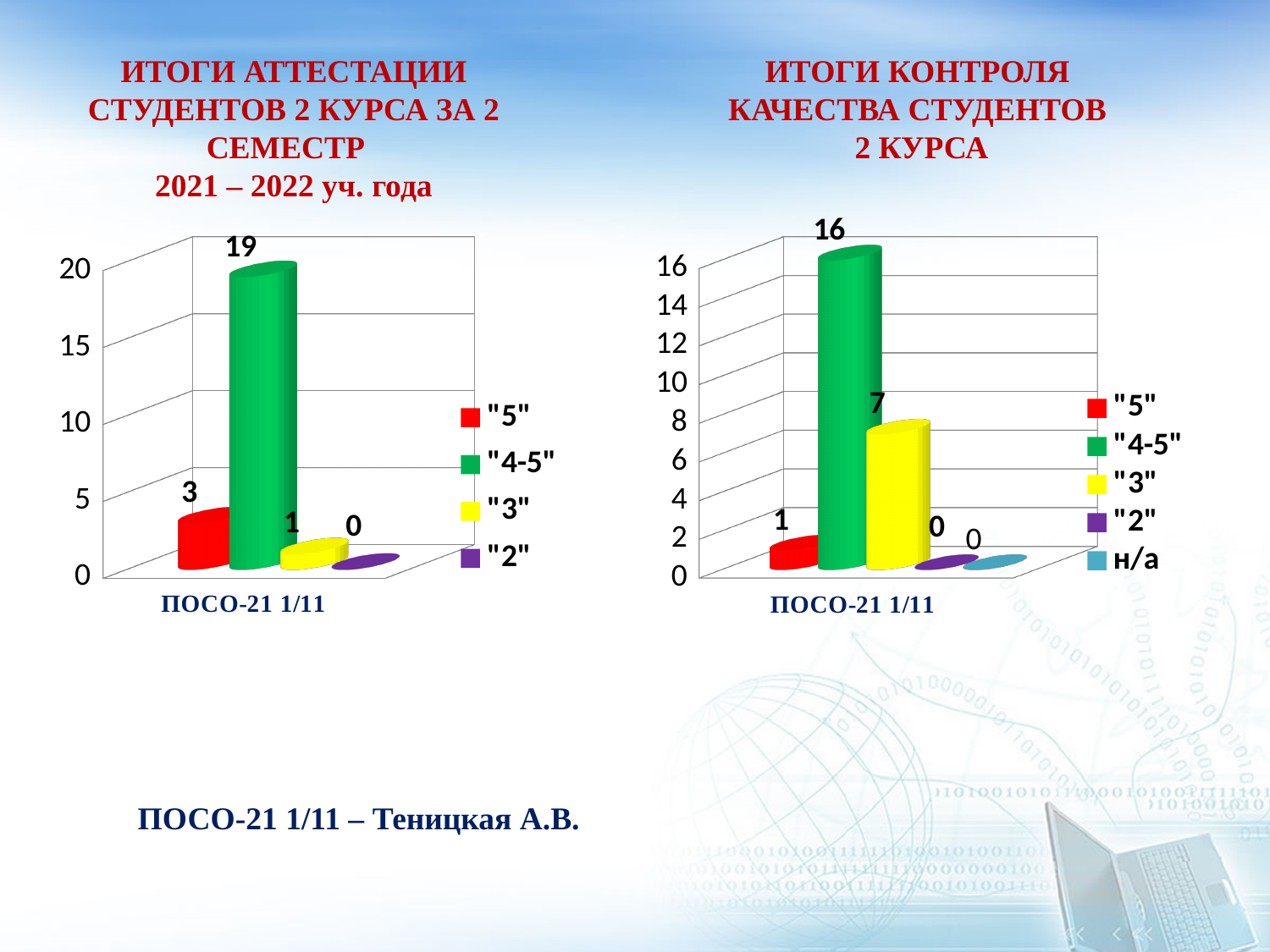
In the right chart (ИТОГИ КОНТРОЛЯ КАЧЕСТВА), what is the value for the "3" series? 7 In the left chart (ИТОГИ АТТЕСТАЦИИ), what is the difference between the "4-5" value and the "5" value? 16 In the right chart (ИТОГИ КОНТРОЛЯ КАЧЕСТВА), how many series does the legend list? 5 In the right chart (ИТОГИ КОНТРОЛЯ КАЧЕСТВА), what is the difference between the "4-5" value and the "3" value? 9 In the left chart (ИТОГИ АТТЕСТАЦИИ), which series has the highest value? "4-5" In the right chart (ИТОГИ КОНТРОЛЯ КАЧЕСТВА), what is the value for the "4-5" series? 16 In the right chart (ИТОГИ КОНТРОЛЯ КАЧЕСТВА), what colour is the "3" series? Yellow In the left chart (ИТОГИ АТТЕСТАЦИИ), what is the value for the "4-5" series? 19 In the right chart (ИТОГИ КОНТРОЛЯ КАЧЕСТВА), which is larger, the "5" value or the "3" value? "3" In the left chart (ИТОГИ АТТЕСТАЦИИ), what is the value for the "5" series? 3 In the left chart (ИТОГИ АТТЕСТАЦИИ), how many series does the legend list? 4 What kind of chart is the left chart (ИТОГИ АТТЕСТАЦИИ)? Bar chart